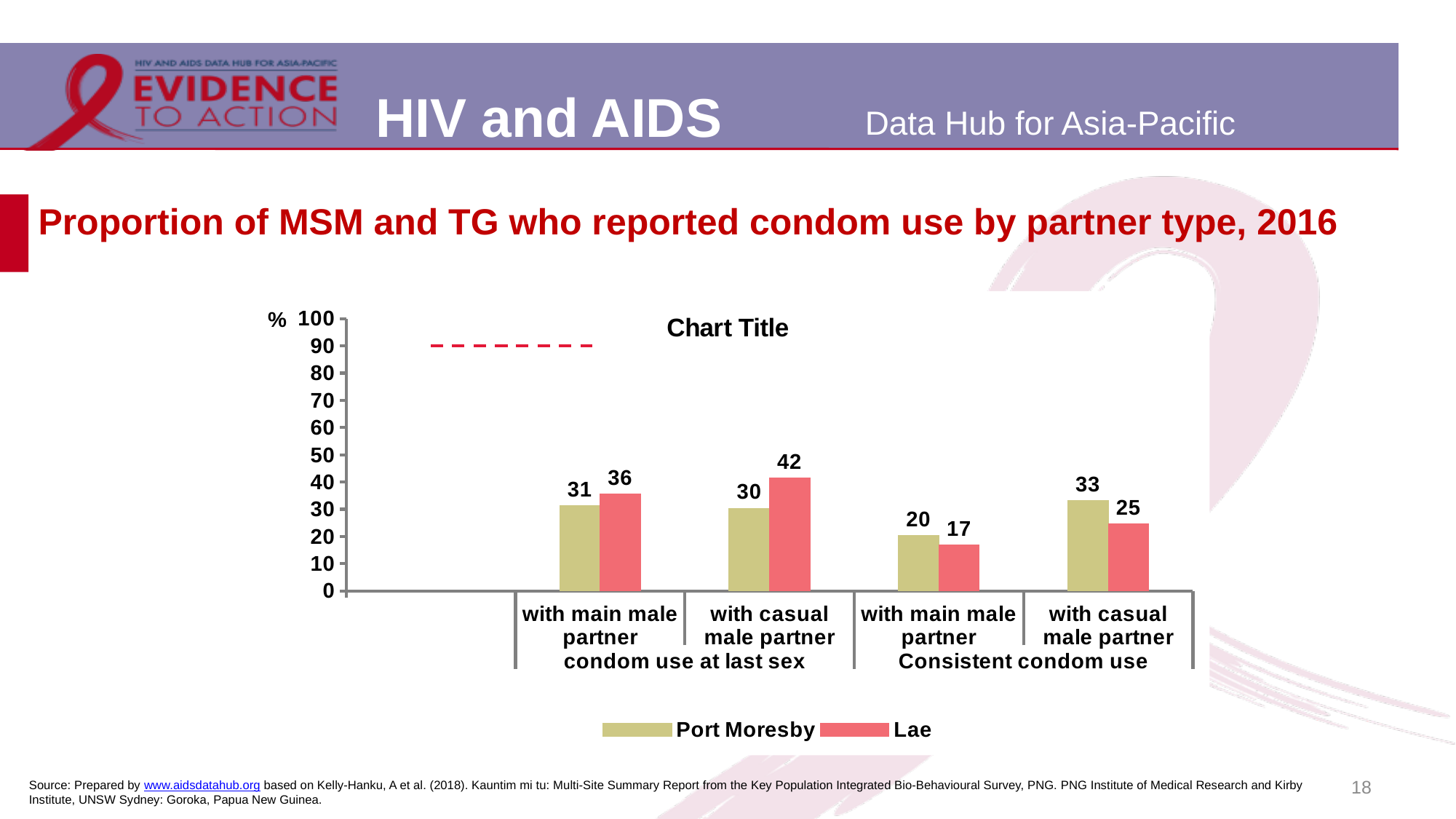
How many series does the chart legend list? 2 What is the value for Port Moresby for condom use at last sex with main male partner? 31 How many categories are shown on the x axis? 4 What is the value for Lae for consistent condom use with casual male partner? 25 What is the difference between the Lae and Port Moresby values for condom use at last sex with casual male partner? 12 Which series is shown in red in the legend? Lae What kind of chart is shown on the slide? bar chart Which category has the lowest value for Port Moresby? consistent condom use with main male partner What is the value for Lae for condom use at last sex with casual male partner? 42 Which category has the highest value for Lae? condom use at last sex with casual male partner For consistent condom use with casual male partner, which is larger: Port Moresby or Lae? Port Moresby What is the value for Port Moresby for consistent condom use with main male partner? 20